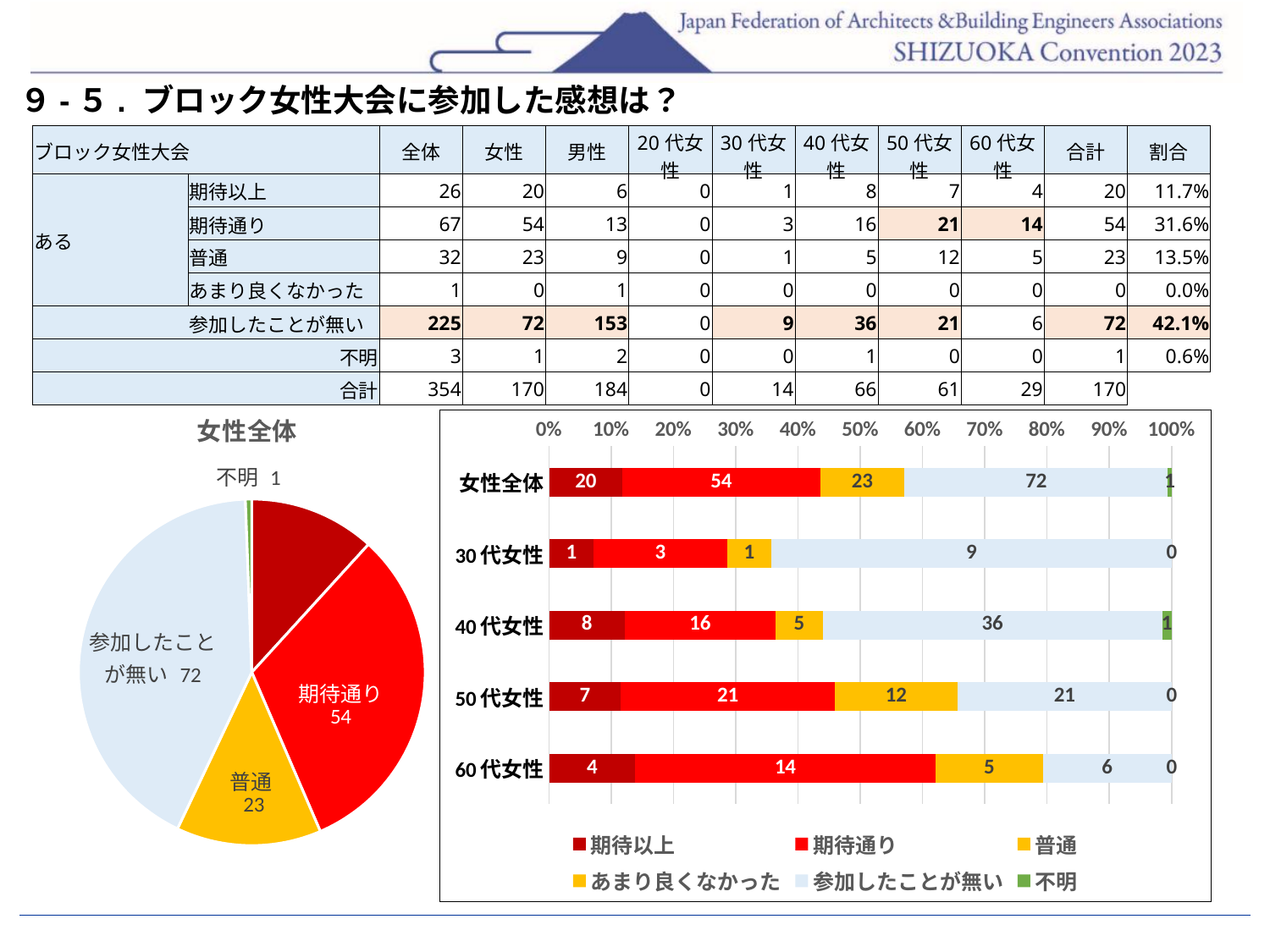
In the pie chart titled 女性全体, what is the value for 不明? 1 What kind of chart is the chart on the left of the slide? pie chart What kind of chart is the chart on the right of the slide? bar chart In the bar chart on the right, what is the 期待通り value for 50代女性? 21 In the bar chart on the right, how many series does the legend list? 6 In the bar chart on the right, for 60代女性, which is larger: 期待通り or 参加したことが無い? 期待通り In the bar chart on the right, what is the difference between the 期待通り value and the 普通 value for 女性全体? 31 In the bar chart on the right, how many categories are plotted? 5 In the pie chart titled 女性全体, what is the value for 普通? 23 In the bar chart on the right, what is the 参加したことが無い value for 40代女性? 36 In the pie chart titled 女性全体, what is the value for 参加したことが無い? 72 What is the title of the pie chart on the left? 女性全体